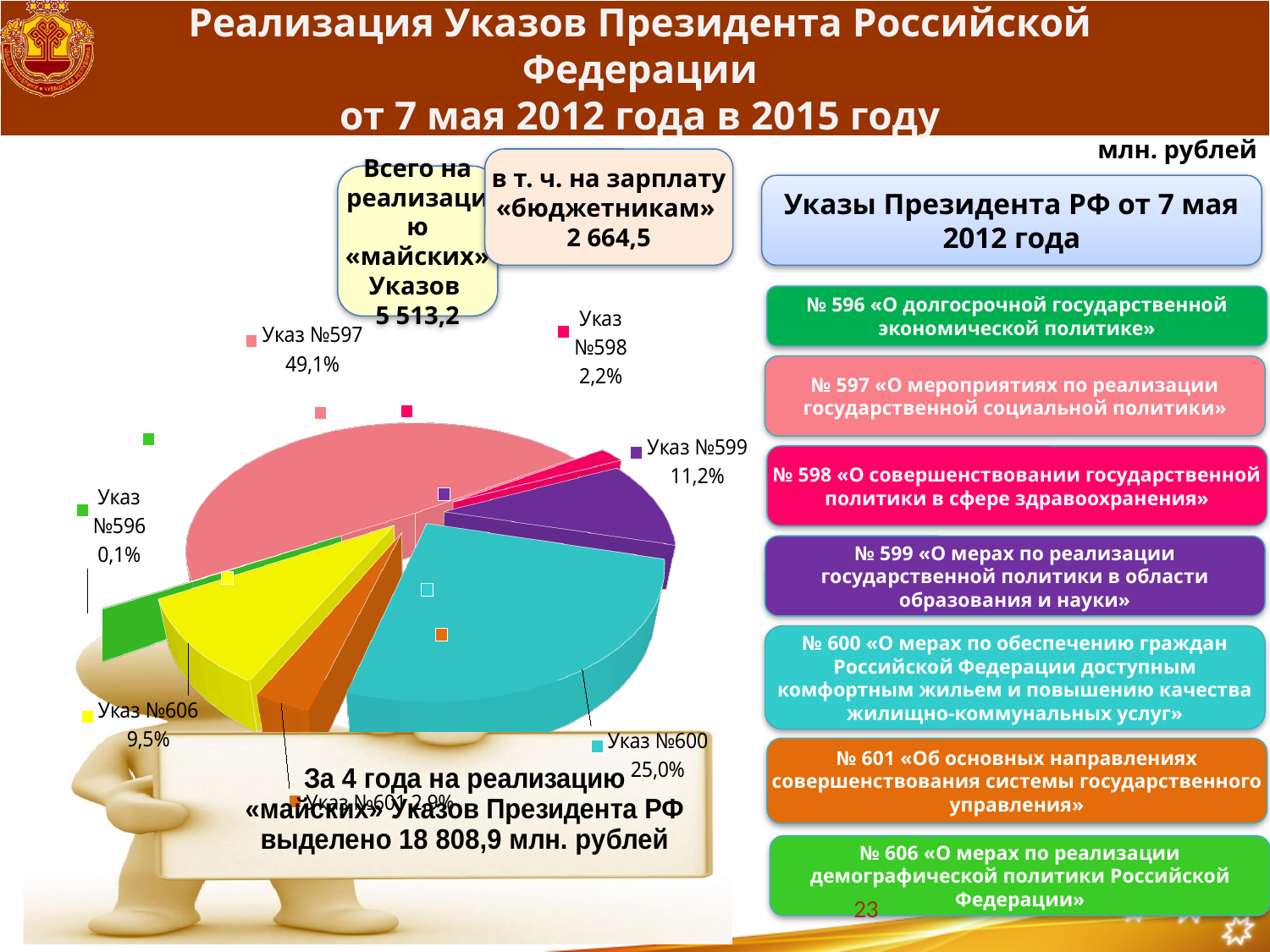
What share of the pie chart does Указ №597 account for? 49,1% Which decree (Указ) has the smallest slice of the pie chart? Указ №596 By how many percentage points does the share of Указ №597 exceed that of Указ №600? 24,1 percentage points Which has the larger share in the pie chart, Указ №599 or Указ №606? Указ №599 How many slices (decrees) does the pie chart contain? 7 What share does Указ №606 have in the pie chart? 9,5% What percentage is labelled for Указ №598 in the pie chart? 2,2% What type of chart is used on the slide? Pie chart What percentage is shown for Указ №599 in the pie chart? 11,2% Which decree (Указ) has the largest slice of the pie chart? Указ №597 What percentage is shown for Указ №600 in the pie chart? 25,0% What percentage is labelled for Указ №596 in the pie chart? 0,1%